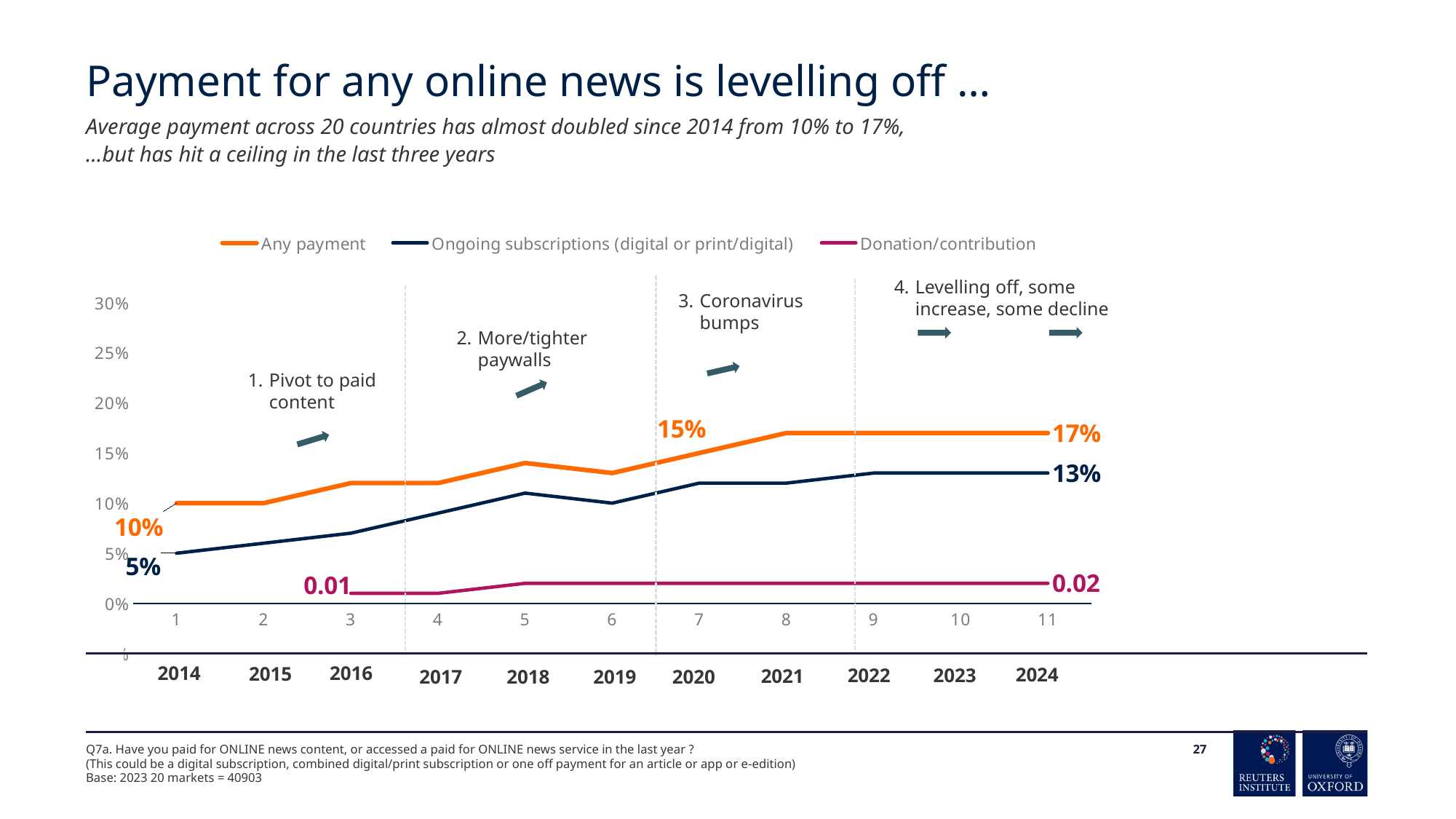
Does the Any payment line rise or fall from 2014 to 2024? Rise Which series has the lowest values across all years? Donation/contribution What kind of chart is shown on the slide? Line chart In 2024, which is larger: Any payment or Ongoing subscriptions? Any payment What is the value for Any payment in 2014? 10% By how many percentage points did Any payment increase from 2014 to 2024? 7 percentage points What is the value for Any payment in 2024? 17% How many series does the legend list? 3 What is the value for Donation/contribution in 2024? 0.02 How many years are plotted along the x axis? 11 Is the value for Ongoing subscriptions in 2018 greater or less than 15%? less What is the value for Ongoing subscriptions (digital or print/digital) in 2024? 13%